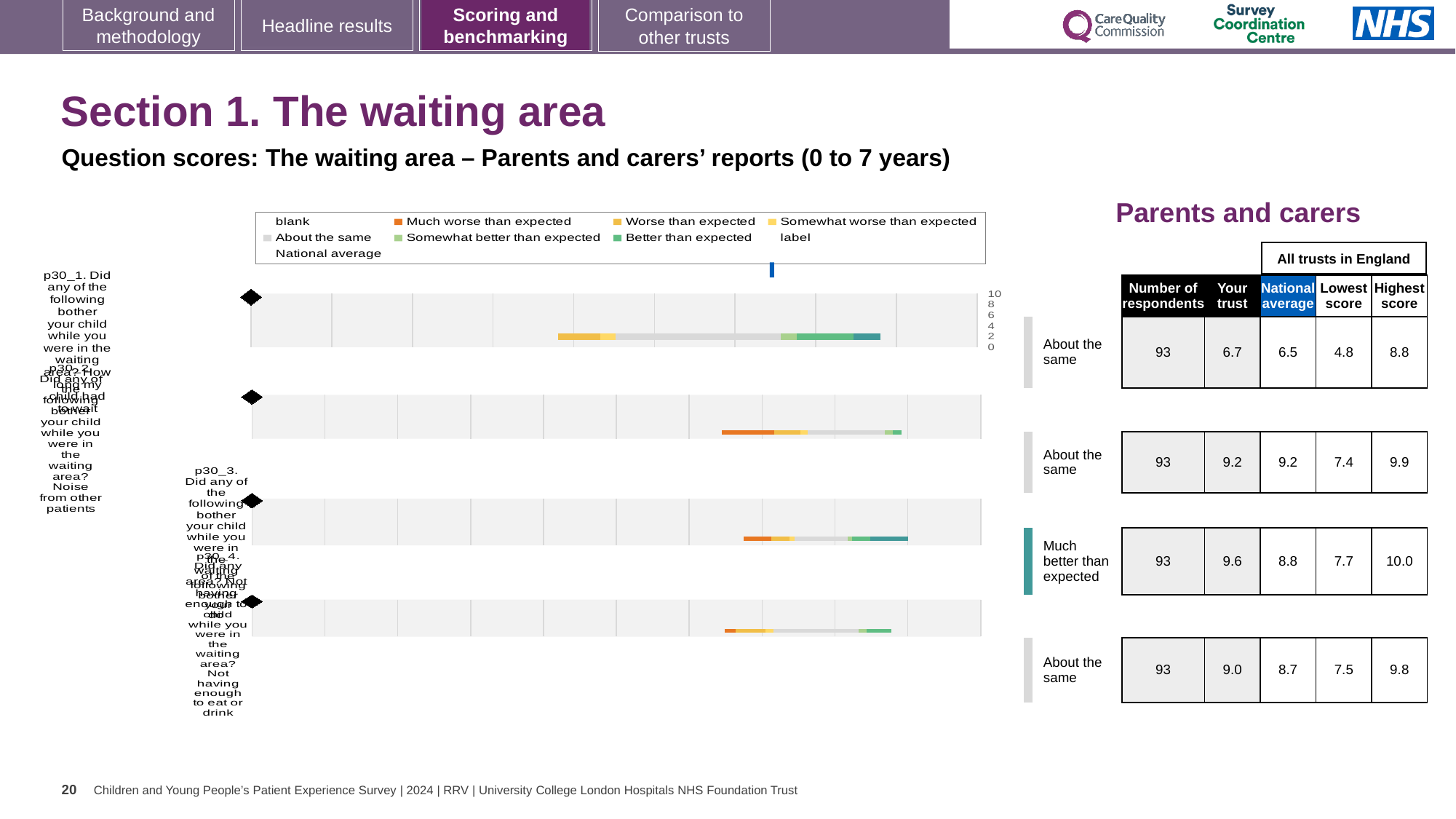
In the table to the right of the chart, which question has the lowest 'Your trust' score? the first question (6.7) What kind of chart is shown on the slide? bar chart How many entries does the chart's legend list? 9 In the table to the right of the chart, what is the difference between the 'Your trust' score and the national average for the third question? 0.8 In the table to the right of the chart, what is the highest score in England for the third question? 10.0 How many question bars (categories) are plotted in the chart? 4 In the table to the right of the chart, what is the number of respondents for each question? 93 In the table to the right of the chart, is the 'Your trust' score for the fourth question larger or smaller than its national average? larger What is the maximum value shown on the chart's axis? 10 In the table to the right of the chart, what is the national average for the first question? 6.5 Which colour does the legend use for 'Much worse than expected'? orange In the table to the right of the chart, what is the 'Your trust' score for the third question (rated 'Much better than expected')? 9.6